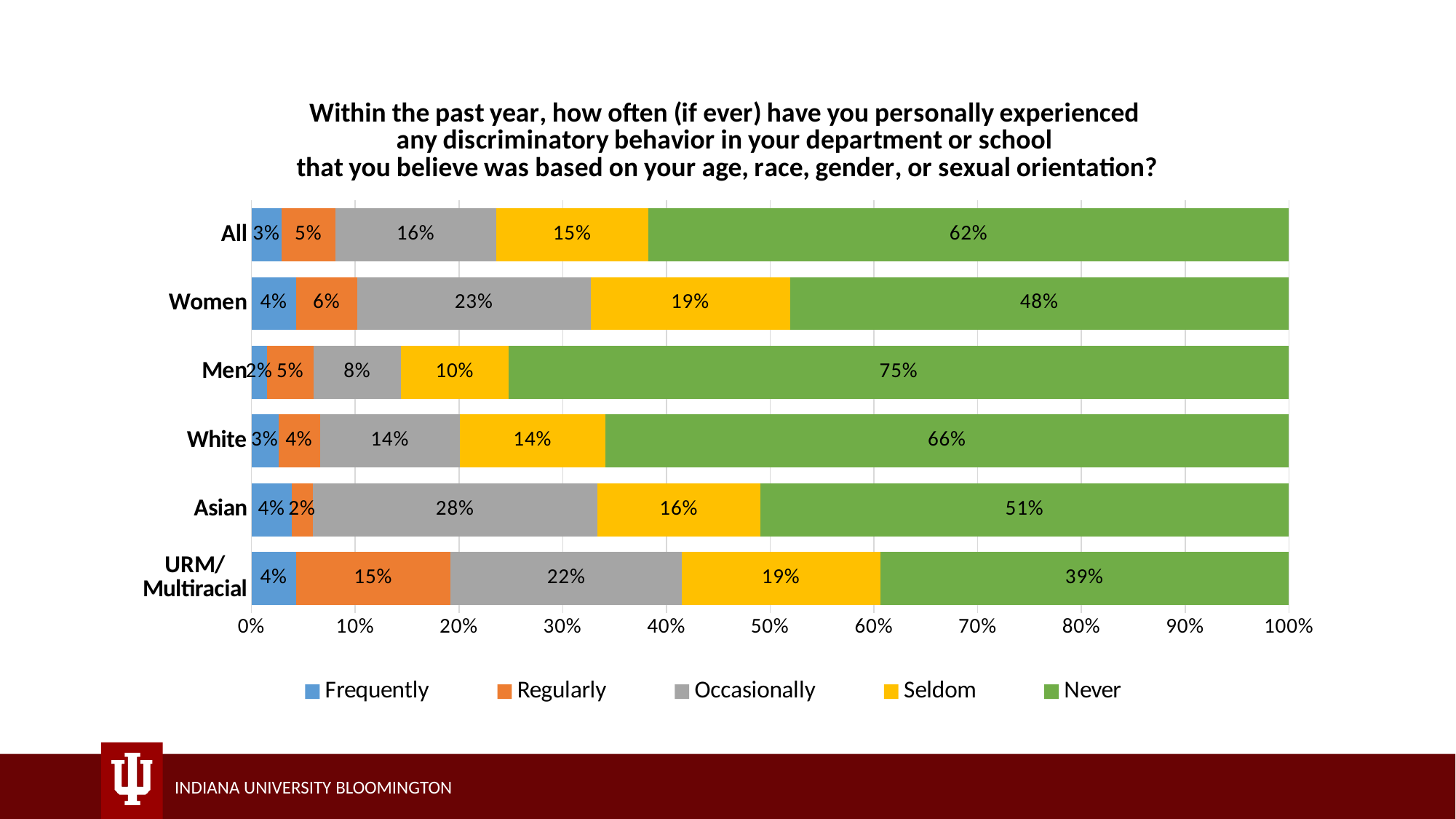
What kind of chart is shown on the slide? Stacked bar chart What is the total of the segments in the Men bar? 100% What percentage of URM/Multiracial respondents answered "Regularly"? 15% What percentage of Asian respondents answered "Occasionally"? 28% How many percentage points higher is the "Never" value for Men than for Women? 27 percentage points How many groups (bars) are shown in the chart? 6 Which group has the lowest "Never" percentage? URM/Multiracial What is the difference between the "Occasionally" values for Asian and White respondents? 14 percentage points Which group has the highest "Never" percentage? Men Which group has a larger "Seldom" value, Women or White? Women How many response categories does the legend list? 5 What percentage of Men answered "Never"? 75%